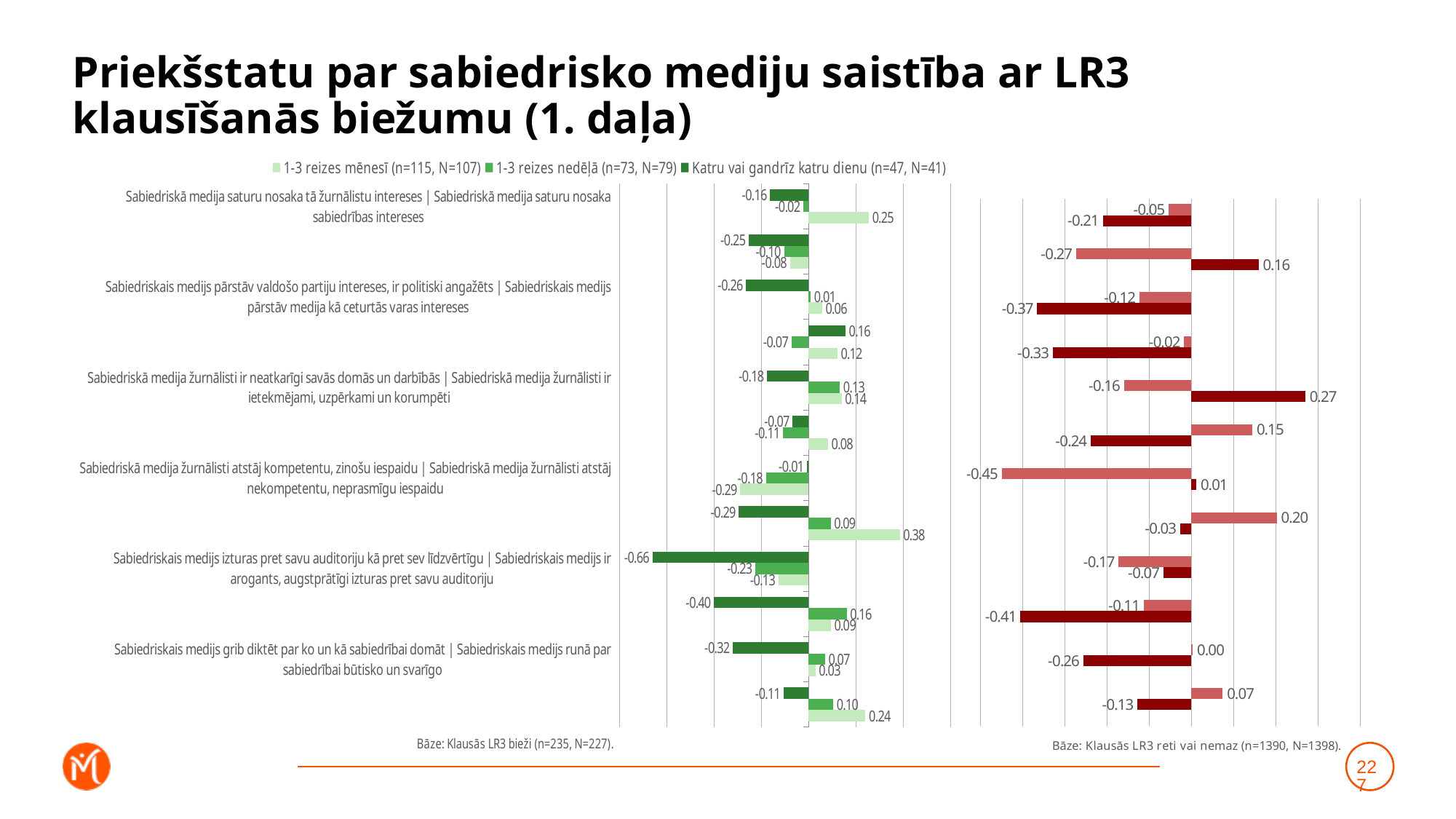
In the left (green) chart, what is the value of the light green bar in the topmost group? 0.25 What kind of chart is the left (green) chart on the slide? bar chart What base note is printed under the left (green) chart? Bāze: Klausās LR3 bieži (n=235, N=227). What is the legend entry for the lightest green series? 1-3 reizes mēnesī (n=115, N=107) In the left (green) chart, what is the highest value shown? 0.38 In the right (red) chart, what is the value of the dark red bar in the topmost group? -0.21 In the left (green) chart, what is the difference between the highest value (0.38) and the lowest value (-0.66)? 1.04 In the right (red) chart, what is the lowest value shown? -0.45 How many series does the legend at the top of the slide list? 3 Which chart has the larger maximum value, the left (green) chart with 0.38 or the right (red) chart with 0.27? the left (green) chart In the left (green) chart, what is the lowest value shown? -0.66 In the right (red) chart, what is the highest value shown? 0.27